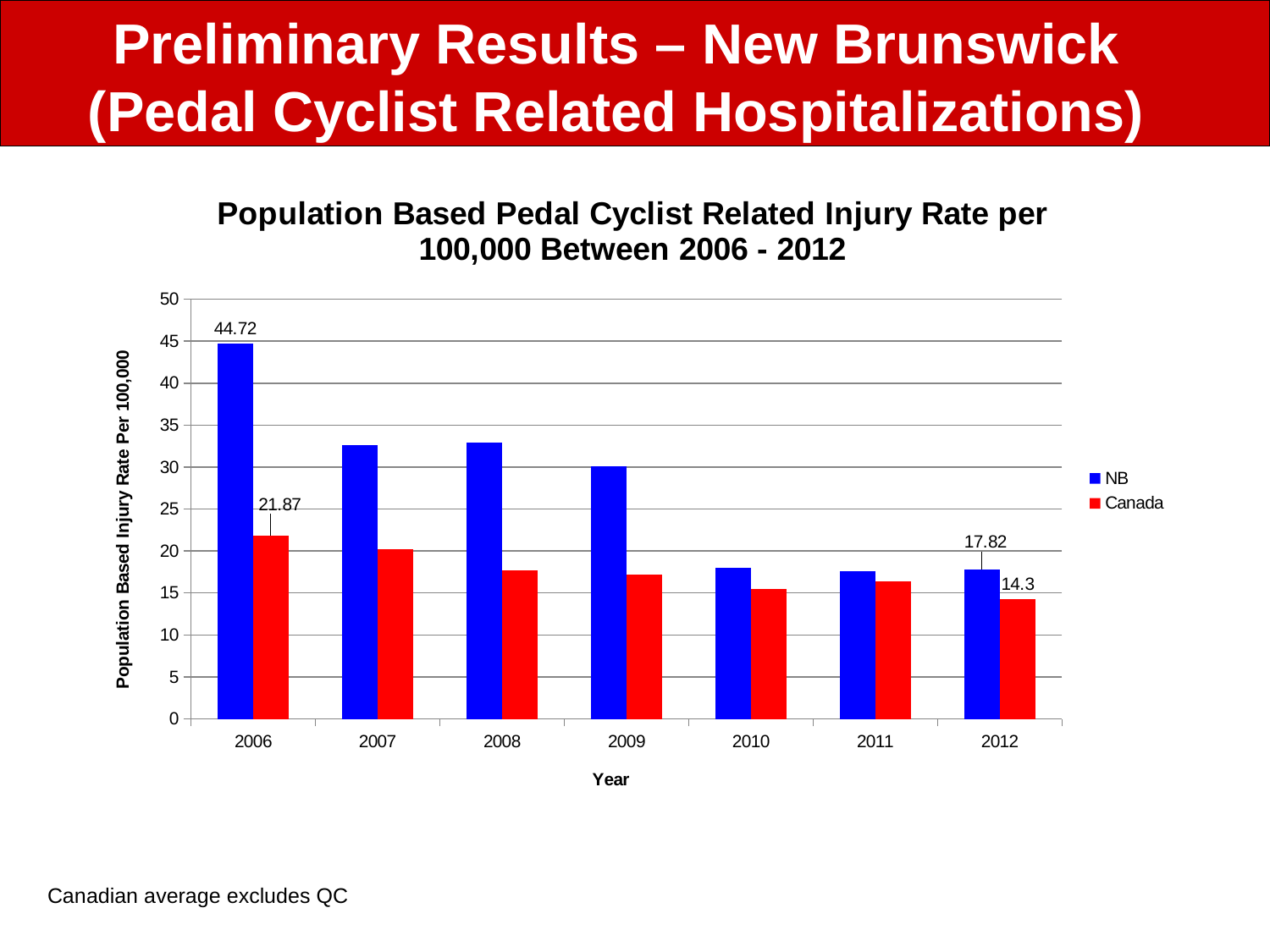
How many years are shown on the x axis? 7 Which is larger in 2009, the NB rate or the Canada rate? NB In which year is the NB injury rate highest? 2006 What is the difference between the NB and Canada injury rates in 2012? 3.52 What kind of chart is shown on the slide? Bar chart What is the difference between the NB and Canada injury rates in 2006? 22.85 How many series does the legend list? 2 Is the NB injury rate in 2008 greater or less than 30? greater What is the Canada injury rate per 100,000 in 2012? 14.3 What is the NB injury rate per 100,000 in 2006? 44.72 What is the NB injury rate per 100,000 in 2012? 17.82 What is the Canada injury rate per 100,000 in 2006? 21.87